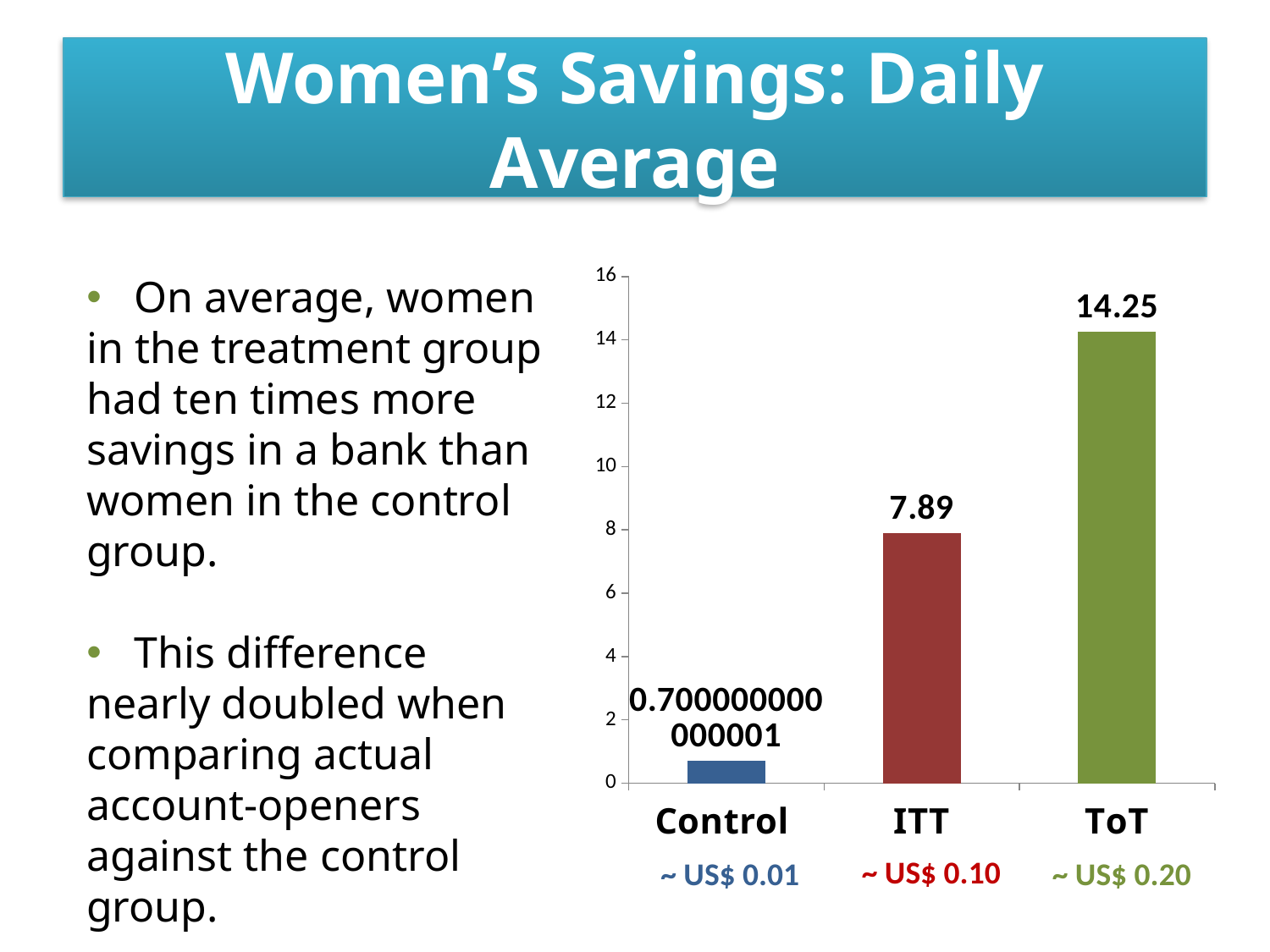
What kind of chart is shown on the slide? bar chart What is the value for ITT? 7.89 How many categories are shown on the x axis? 3 Do the values rise or fall from Control to ToT along the x axis? rise Which category has the lowest value? Control What is the value for ToT? 14.25 Which category has the highest value? ToT Which is larger, the value for ITT or the value for Control? ITT Is the value for ToT greater or less than 12? greater What is the difference between the values for ToT and ITT? 6.36 What is the data label shown on the Control bar? 0.700000000000001 Is the value for Control greater or less than 2? less